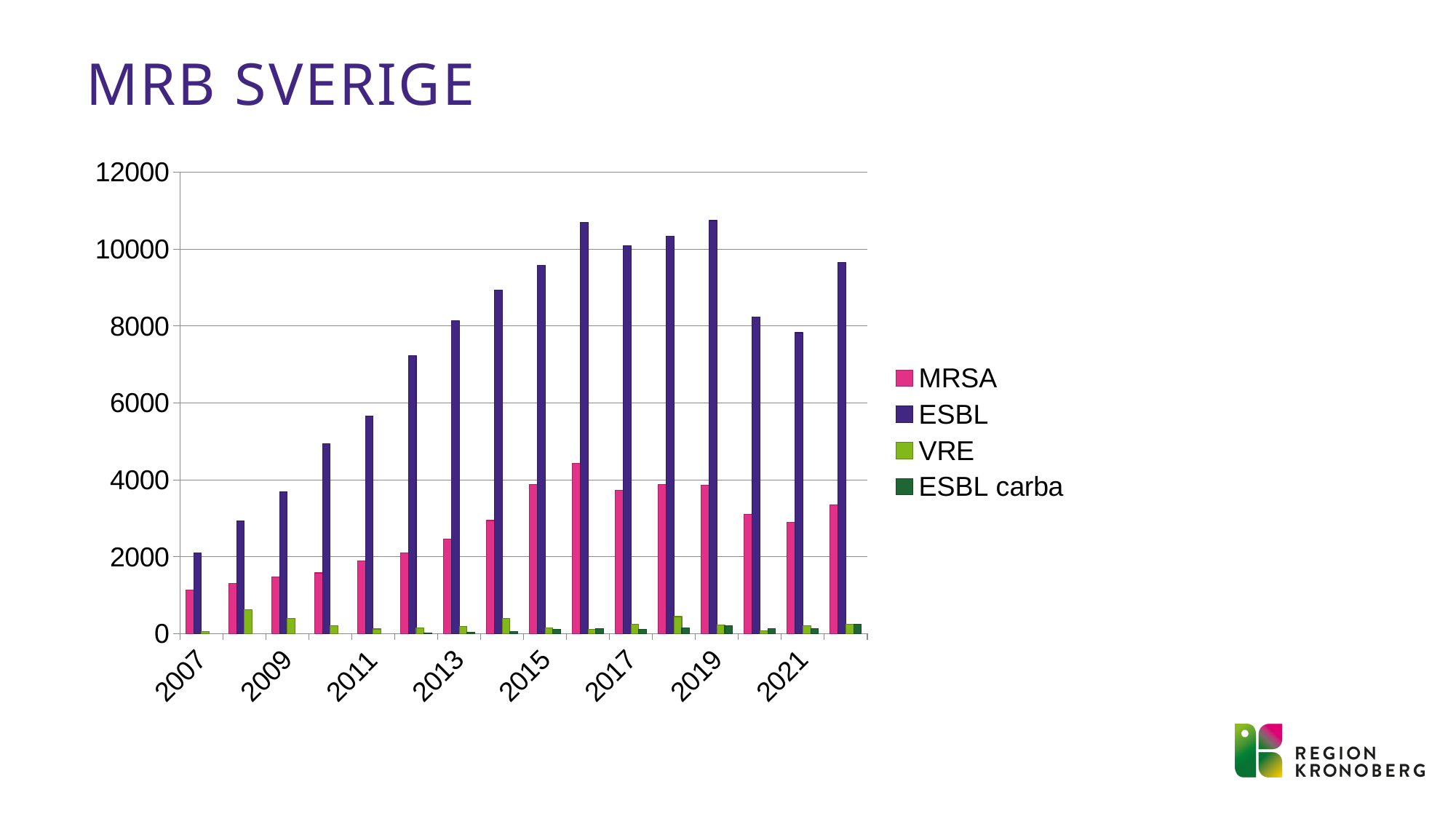
What are the series listed in the legend? MRSA, ESBL, VRE, ESBL carba Which series has the highest value in 2015? ESBL What is the title of the slide? MRB SVERIGE How many years (bar groups) are plotted on the x axis? 16 Is the ESBL value for 2007 greater or less than 4000? less Is the MRSA value for 2016 greater or less than 4000? greater Is the ESBL value for 2011 greater or less than 6000? less Does the ESBL value rise or fall from 2007 to 2016? rise How many series does the legend list? 4 What kind of chart is shown on the slide? bar chart In which year is the MRSA value lowest? 2007